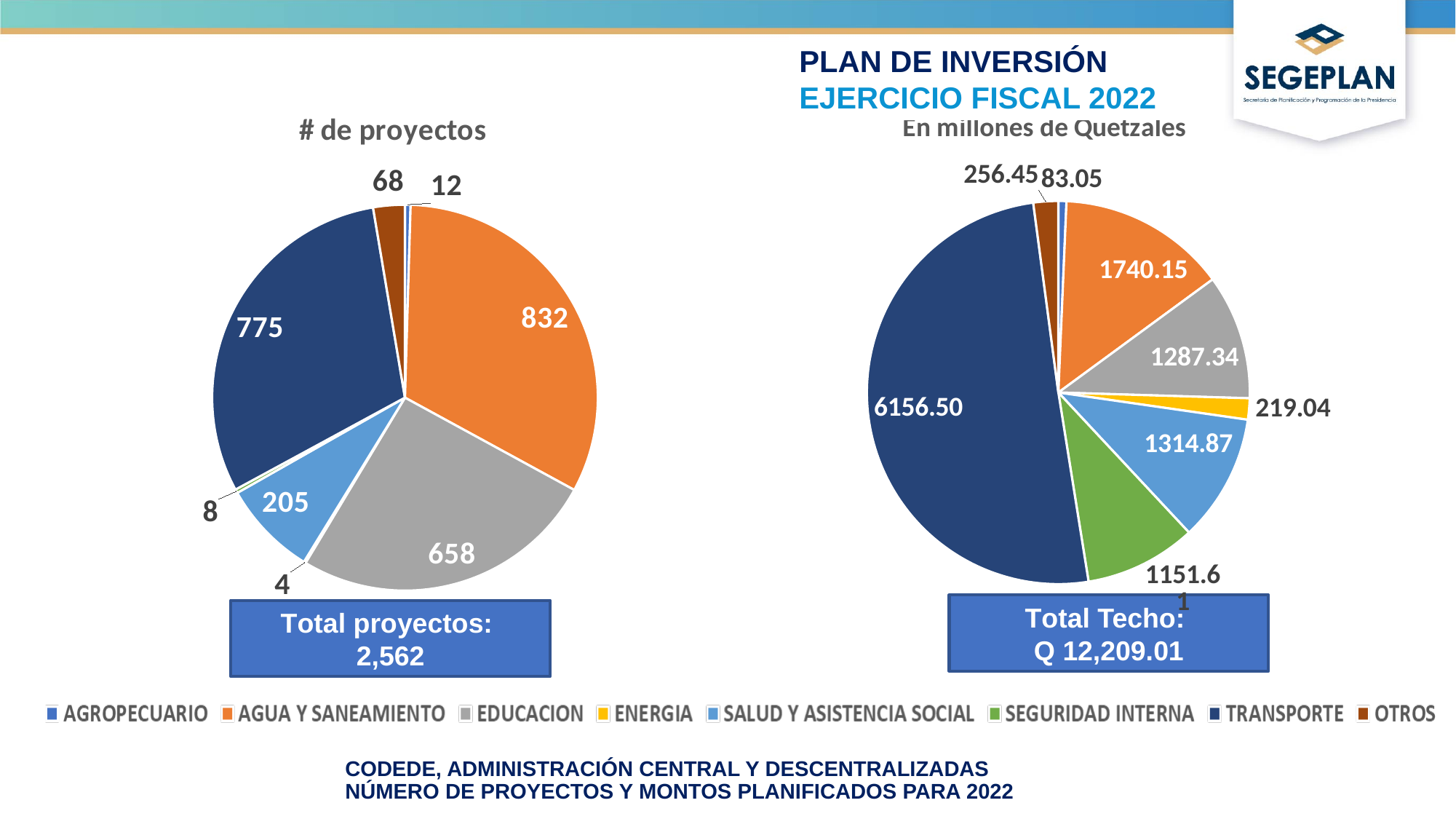
In the '# de proyectos' chart, how many projects are shown for TRANSPORTE? 775 How many categories does the legend at the bottom of the slide list? 8 In the 'En millones de Quetzales' chart, what is the value for EDUCACION? 1287.34 In the '# de proyectos' chart, how many projects are shown for AGUA Y SANEAMIENTO? 832 In the '# de proyectos' chart, what is the difference between the number of projects for AGUA Y SANEAMIENTO and EDUCACION? 174 What type of chart is used on the left side of the slide for '# de proyectos'? Pie chart In the '# de proyectos' chart, which category has the fewest projects? ENERGIA In the 'En millones de Quetzales' chart, which is larger, the value for AGUA Y SANEAMIENTO or the value for SALUD Y ASISTENCIA SOCIAL? AGUA Y SANEAMIENTO What total is shown in the box below the 'En millones de Quetzales' chart? Q 12,209.01 In the 'En millones de Quetzales' chart, what is the value for TRANSPORTE? 6156.50 In the 'En millones de Quetzales' chart, which category has the largest amount? TRANSPORTE In the 'En millones de Quetzales' chart, what is the difference between the values for OTROS and AGROPECUARIO? 173.40